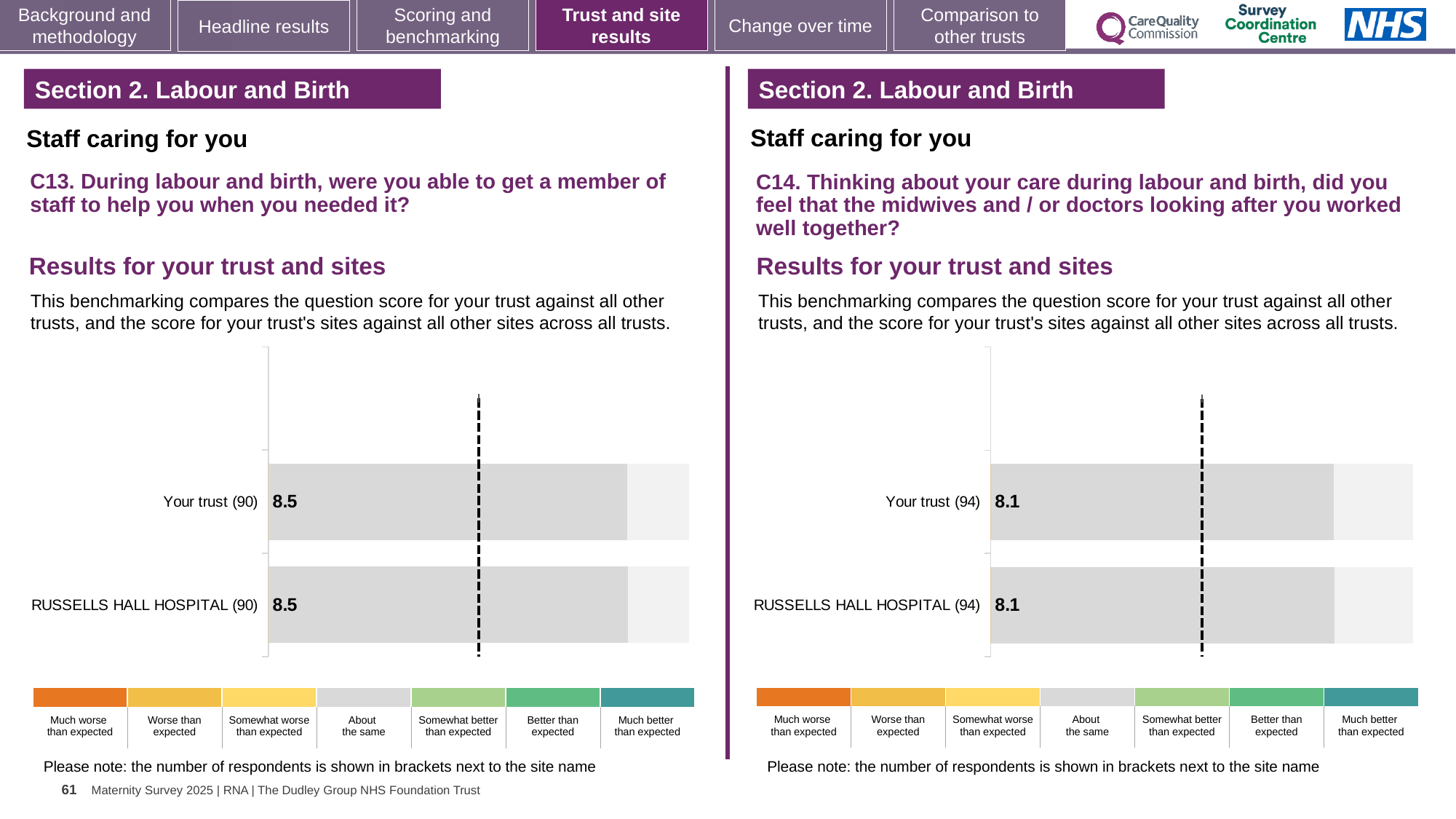
On the C13 chart (left), what is the score for RUSSELLS HALL HOSPITAL? 8.5 On the C14 chart (right), what is the score for Your trust? 8.1 On the C14 chart (right), what is the difference between the score for Your trust and the score for RUSSELLS HALL HOSPITAL? 0 Is the score for Your trust on the C13 chart (left) larger than the score for Your trust on the C14 chart (right)? Yes How many bars are plotted on the C13 chart (left)? 2 On the C13 chart (left), how many respondents are shown in brackets for Your trust? 90 On the C13 chart (left), what is the difference between the score for Your trust and the score for RUSSELLS HALL HOSPITAL? 0 What kind of chart is used on the C13 chart (left)? Bar chart On the C14 chart (right), how many respondents are shown in brackets for RUSSELLS HALL HOSPITAL? 94 How many bars are plotted on the C14 chart (right)? 2 On the C13 chart (left), what is the score for Your trust? 8.5 On the C14 chart (right), what is the score for RUSSELLS HALL HOSPITAL? 8.1